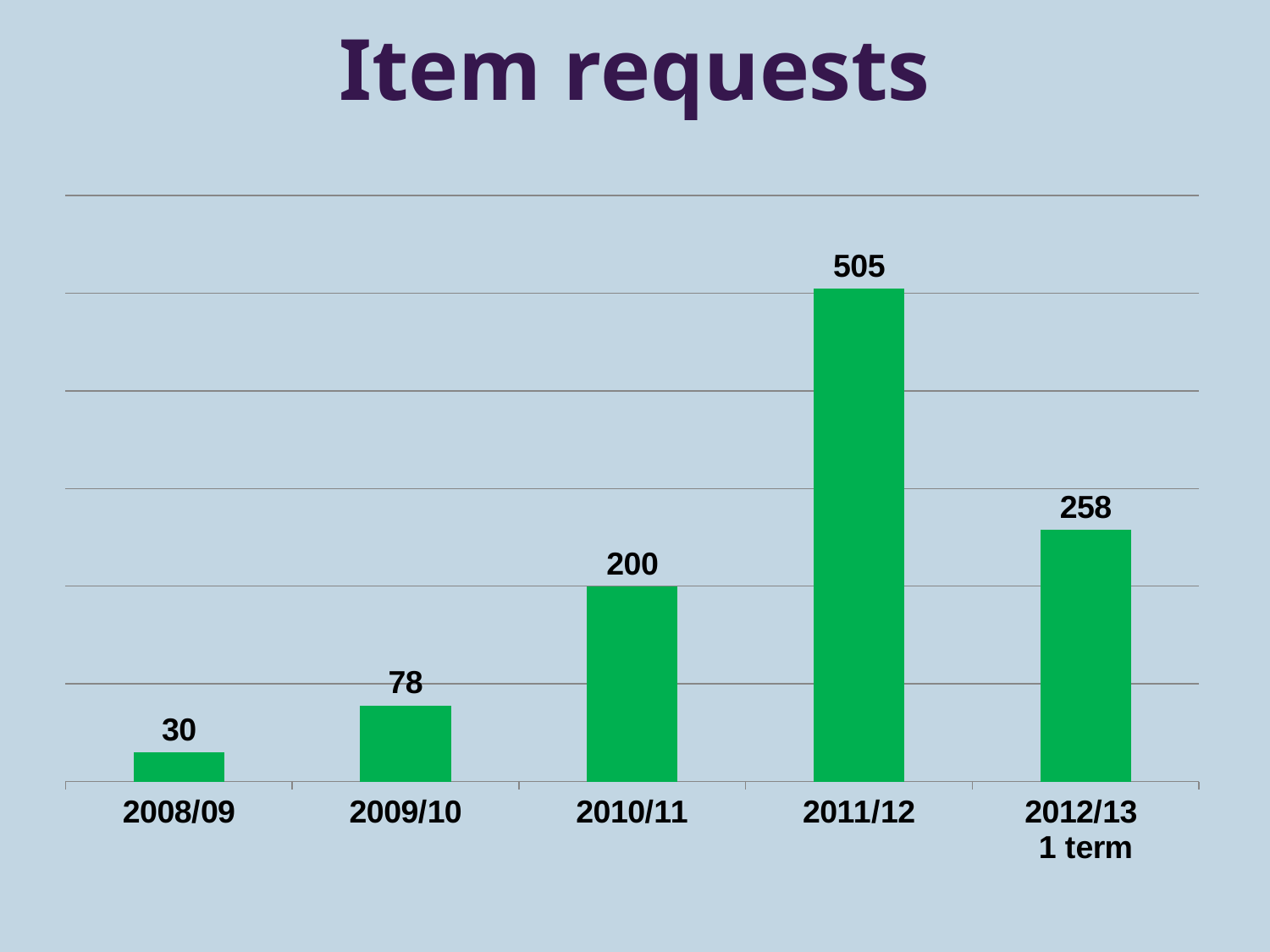
What kind of chart is shown on the slide? bar chart What is the value for 2012/13 1 term? 258 What is the title of the chart? Item requests What is the value for 2008/09? 30 What is the value for 2010/11? 200 Which is larger, the value for 2010/11 or the value for 2012/13 1 term? 2012/13 1 term What is the difference between the values for 2011/12 and 2012/13 1 term? 247 Which year has the highest number of item requests? 2011/12 Which year has the lowest number of item requests? 2008/09 What is the value for 2011/12? 505 What is the difference between the values for 2009/10 and 2008/09? 48 How many categories are shown on the x axis? 5